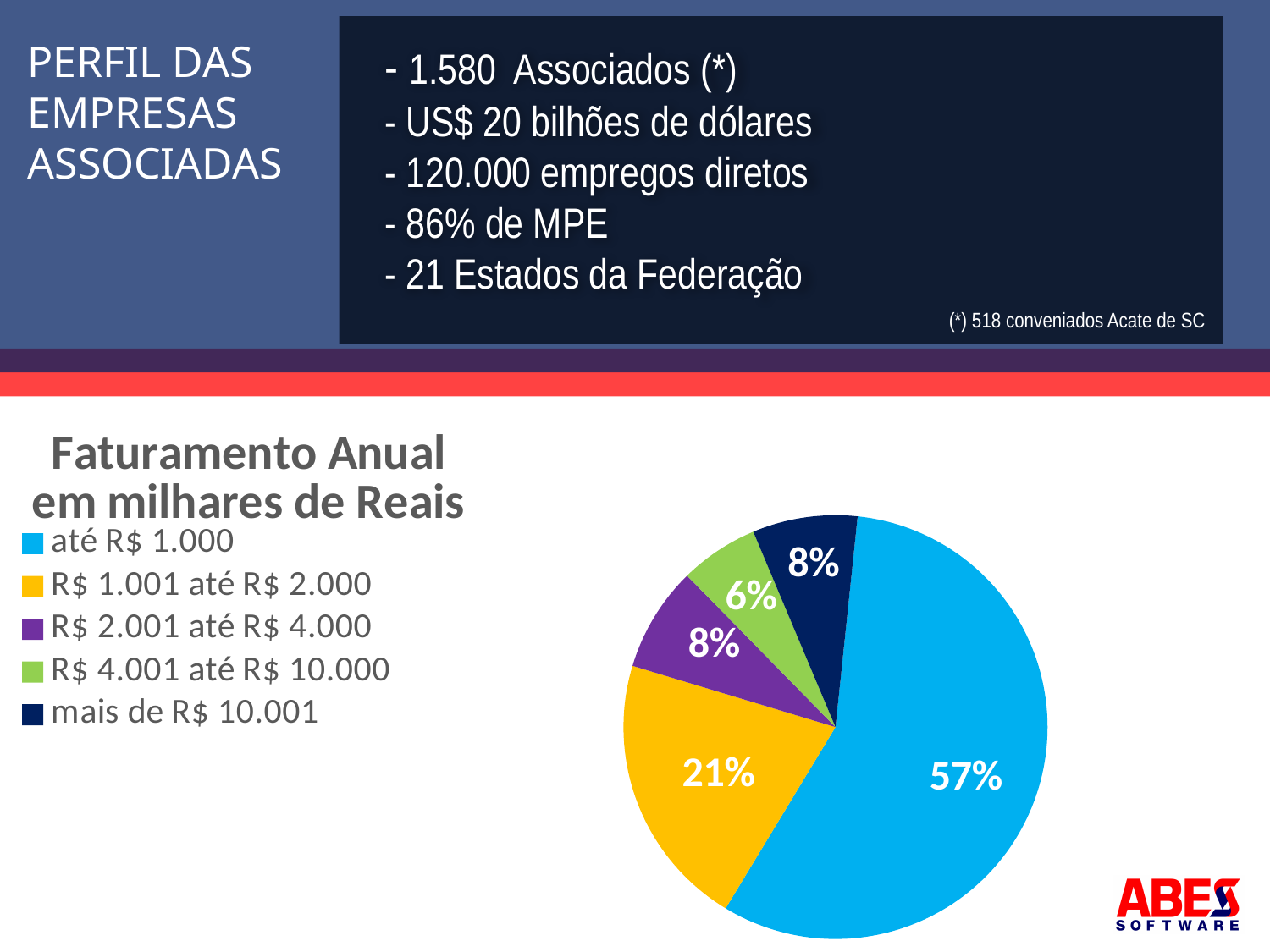
Which category has the smallest slice of the pie? R$ 4.001 até R$ 10.000 What is the value shown for 'R$ 4.001 até R$ 10.000'? 6% How many categories does the pie chart have? 5 What kind of chart is shown on the slide? pie chart What is the value shown for 'mais de R$ 10.001'? 8% What is the title of the chart? Faturamento Anual em milhares de Reais What is the value shown for 'R$ 1.001 até R$ 2.000'? 21% What colour is the slice for 'R$ 2.001 até R$ 4.000'? purple Which category has the largest slice of the pie? até R$ 1.000 What share of the pie does the 'até R$ 1.000' category have? 57% What is the difference in percentage points between 'até R$ 1.000' and 'R$ 1.001 até R$ 2.000'? 36 Which is larger, the slice for 'R$ 1.001 até R$ 2.000' or the slice for 'R$ 2.001 até R$ 4.000'? R$ 1.001 até R$ 2.000